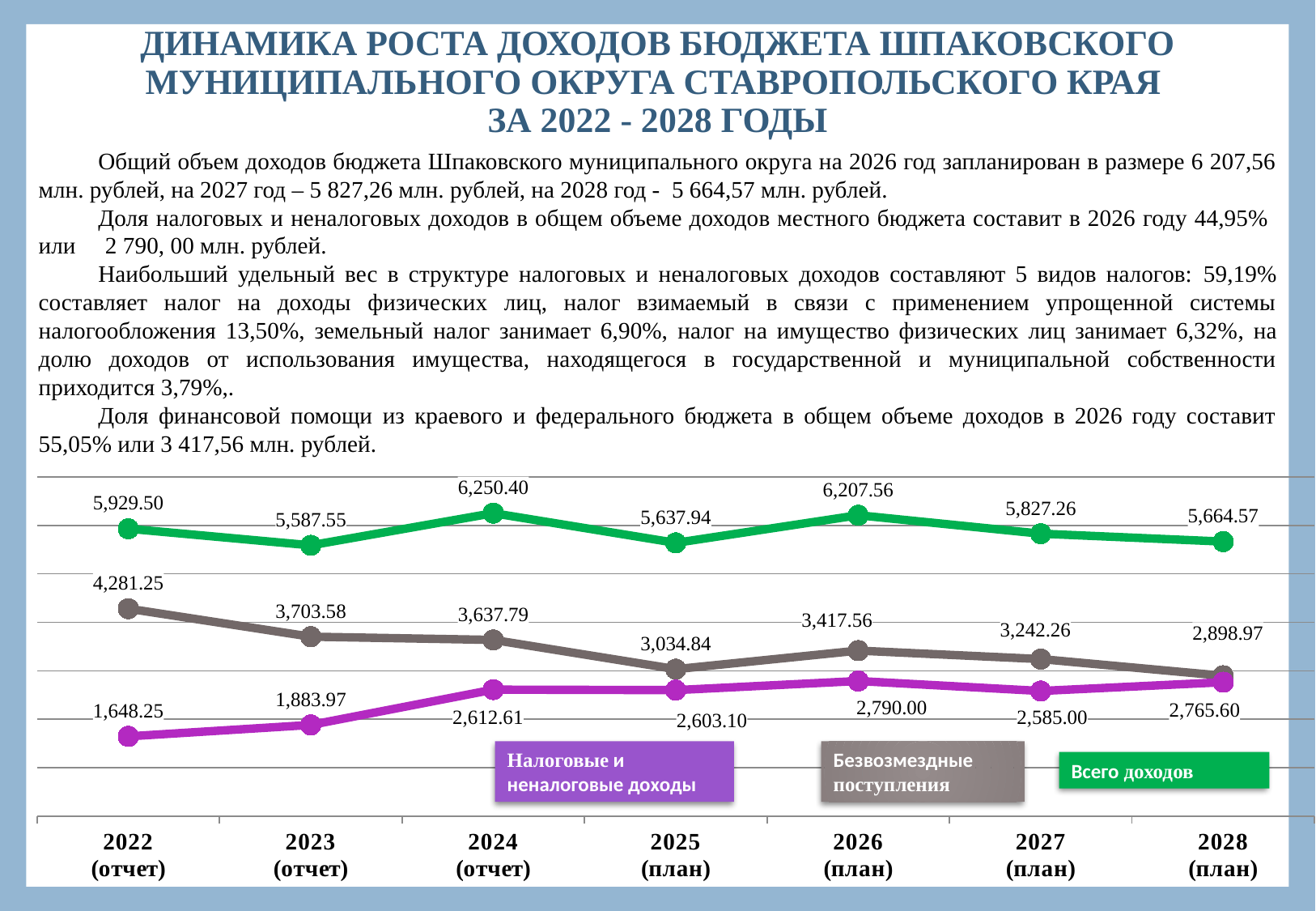
In which year does Всего доходов reach its highest value? 2024 (отчет) How many years are shown on the x axis of the chart? 7 What is the value of Налоговые и неналоговые доходы for 2027 (план)? 2,585.00 What is the difference between Безвозмездные поступления and Налоговые и неналоговые доходы in 2028 (план)? 133.37 What kind of chart is shown on the slide? Line chart What is the value of Всего доходов for 2024 (отчет)? 6,250.40 Which is larger in 2022 (отчет): Безвозмездные поступления or Налоговые и неналоговые доходы? Безвозмездные поступления How many series does the chart's legend list? 3 In which year is Всего доходов lowest? 2023 (отчет) What is the value of Безвозмездные поступления for 2025 (план)? 3,034.84 What is the difference between Всего доходов and Безвозмездные поступления in 2026 (план)? 2,790.00 In which year is Налоговые и неналоговые доходы lowest? 2022 (отчет)